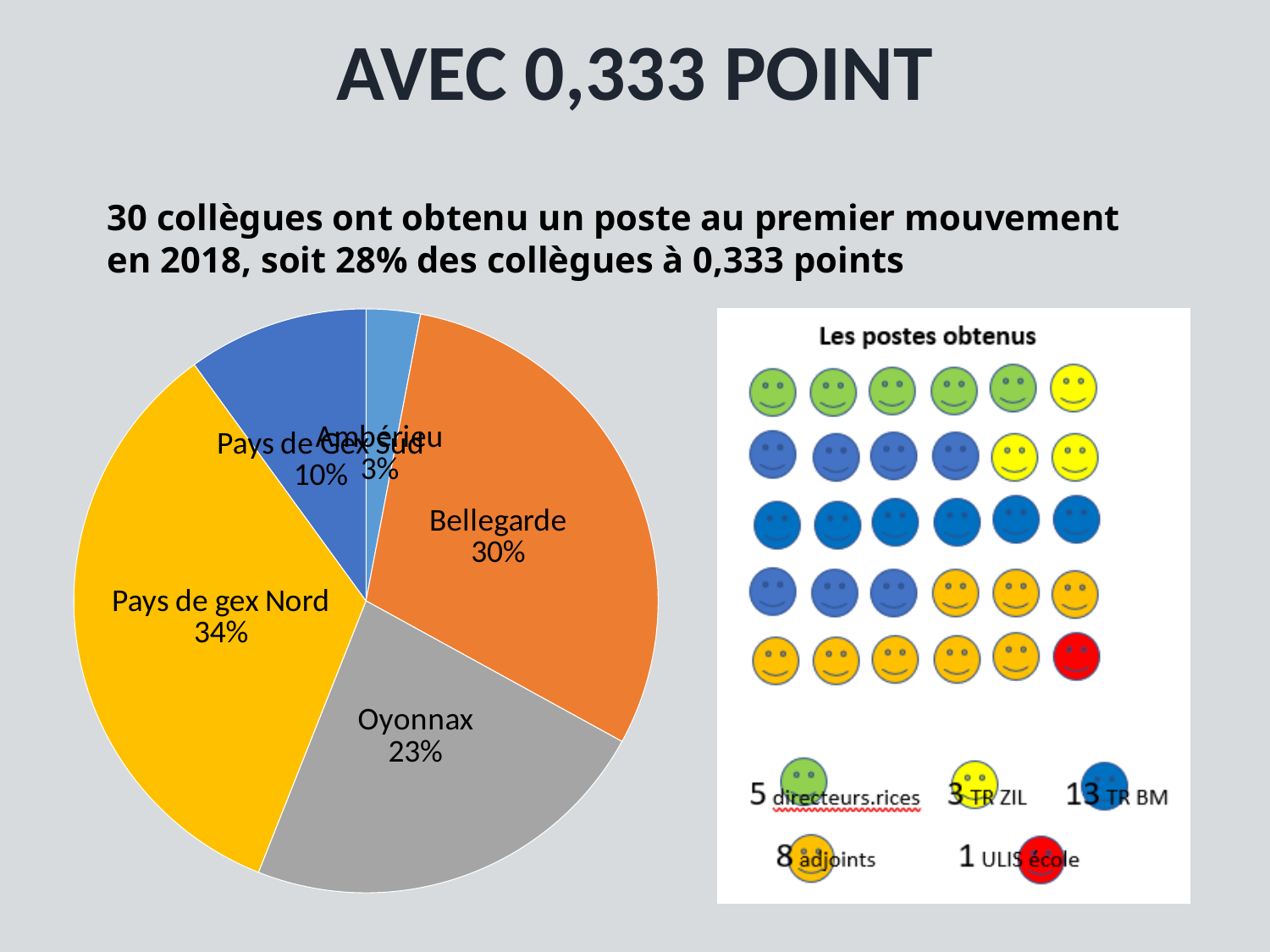
Which slice of the pie chart is the smallest? Ambérieu In the pie chart, which is larger: Bellegarde or Oyonnax? Bellegarde In the pie chart, what share does Pays de Gex Sud have? 10% In the pie chart, what is the difference in percentage points between Pays de gex Nord and Oyonnax? 11 In the pie chart, what share does Bellegarde have? 30% In the pie chart, what share does Oyonnax have? 23% In the pie chart, what colour is the Oyonnax slice? grey In the pie chart, what share does Ambérieu have? 3% How many slices does the pie chart have? 5 In the pie chart, what share does Pays de gex Nord have? 34% Which slice of the pie chart is the largest? Pays de gex Nord What kind of chart is shown on the left of the slide? pie chart